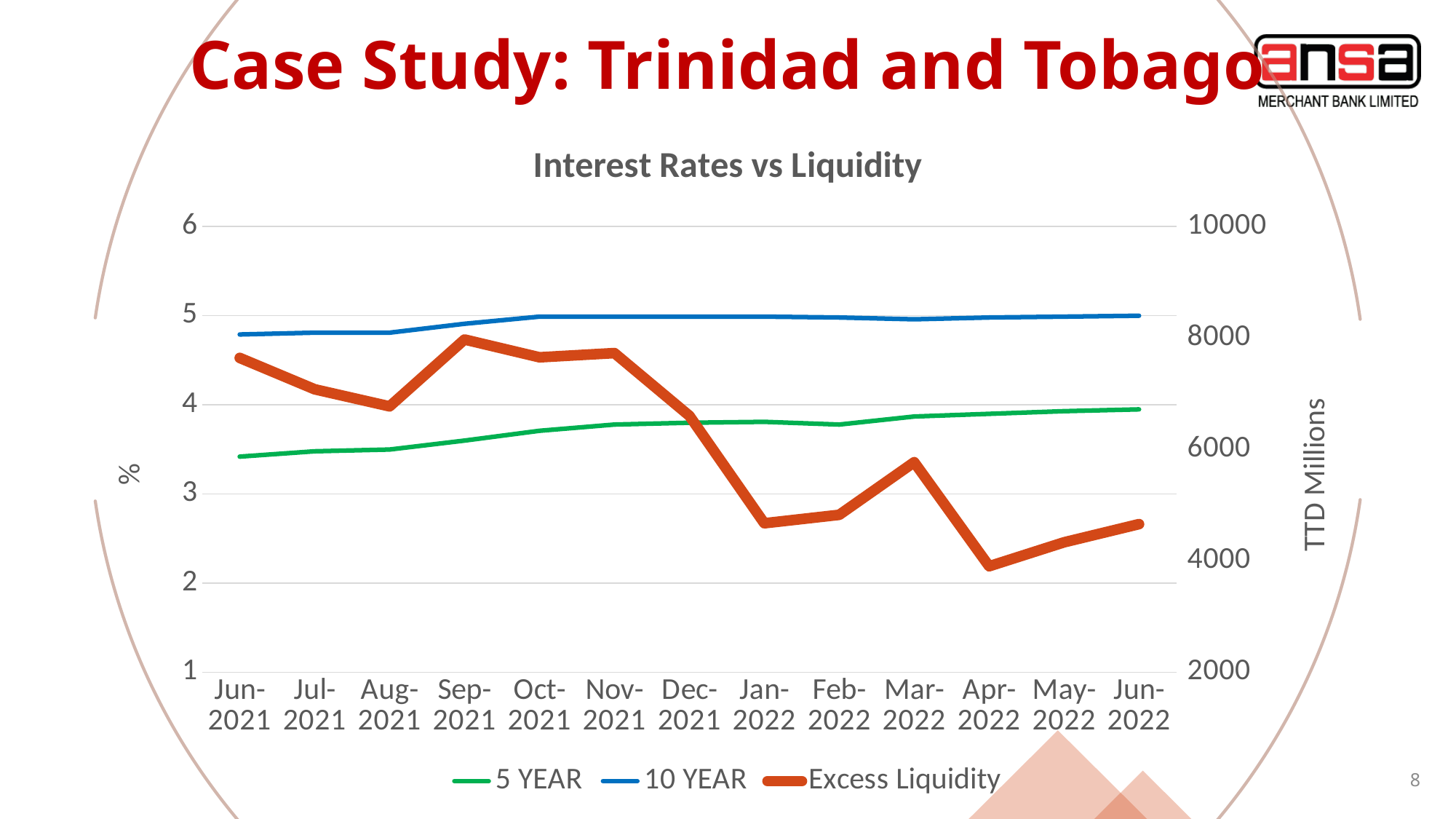
In Jun-2021, which is higher: the 5 YEAR rate or the 10 YEAR rate? 10 YEAR In which month does Excess Liquidity reach its highest value? Sep-2021 Is the Excess Liquidity value for Jun-2021 greater or less than 6000? greater What is the label on the right-hand vertical axis? TTD Millions Is the 5 YEAR value for Jun-2021 greater or less than 4? less Does the 5 YEAR series generally rise or fall from Jun-2021 to Jun-2022? rise Is the 10 YEAR value for Jun-2022 greater or less than 4? greater How many months are plotted along the x axis? 13 In which month does Excess Liquidity reach its lowest value? Apr-2022 What kind of chart is shown on the slide? line chart How many series does the legend list? 3